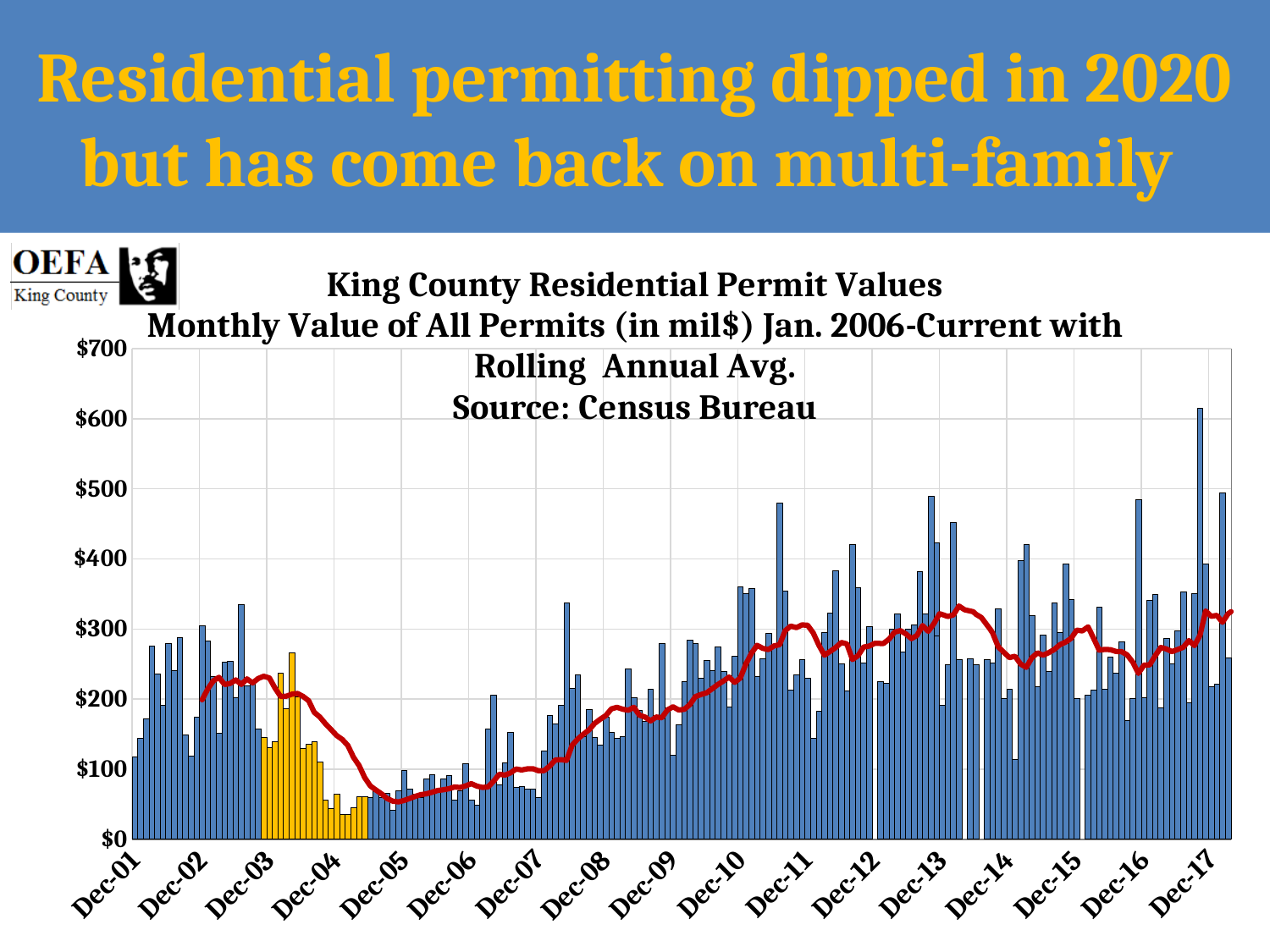
Near which x-axis label does the tallest bar on the chart appear? Dec-17 Is the tallest bar on the chart, near Dec-17, greater or less than $500? greater What is the highest value shown on the y-axis of the chart? $700 Are the gold-coloured bars between Dec-03 and Dec-04 greater or less than $300? less Are the bars around Dec-05 greater or less than $200? less What kind of chart is shown on the slide? bar chart Which is larger: the rolling annual average around Dec-13 or around Dec-05? Dec-13 Does the rolling annual average line rise or fall between Dec-03 and Dec-05? fall Does the rolling annual average line rise or fall between Dec-05 and Dec-10? rise How many date labels are shown along the x-axis of the chart? 17 What is the source of the data cited in the chart title? Census Bureau